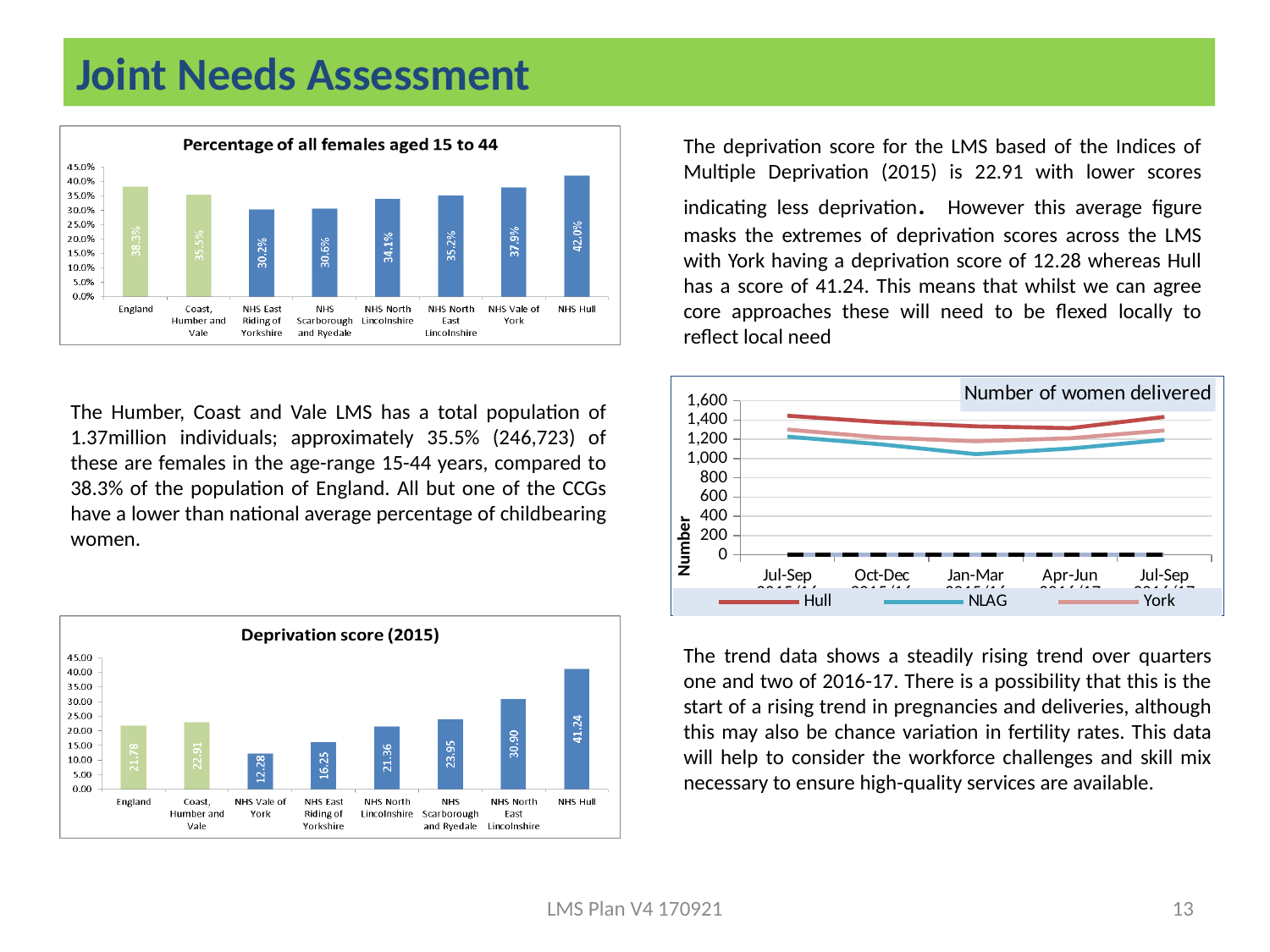
In the 'Deprivation score (2015)' chart, which category has the highest value? NHS Hull In the 'Deprivation score (2015)' chart, which is larger: NHS North Lincolnshire or NHS Scarborough and Ryedale? NHS Scarborough and Ryedale What kind of chart is the 'Number of women delivered' chart? Line chart In the 'Deprivation score (2015)' chart, what is the difference between NHS Hull and NHS North East Lincolnshire? 10.34 In the 'Percentage of all females aged 15 to 44' chart, what is the value for NHS Hull? 42.0% In the 'Percentage of all females aged 15 to 44' chart, which category has the lowest value? NHS East Riding of Yorkshire In the 'Number of women delivered' chart, is the value for Hull in Jul-Sep 2015/16 greater or less than 1,200? greater In the 'Number of women delivered' chart, is the value for NLAG in Jan-Mar 2015/16 greater or less than 1,200? less In the 'Percentage of all females aged 15 to 44' chart, what is the difference between England and Coast, Humber and Vale? 2.8% How many series does the legend of the 'Number of women delivered' chart list? 3 In the 'Percentage of all females aged 15 to 44' chart, how many categories are shown? 8 In the 'Deprivation score (2015)' chart, what is the value for NHS Vale of York? 12.28